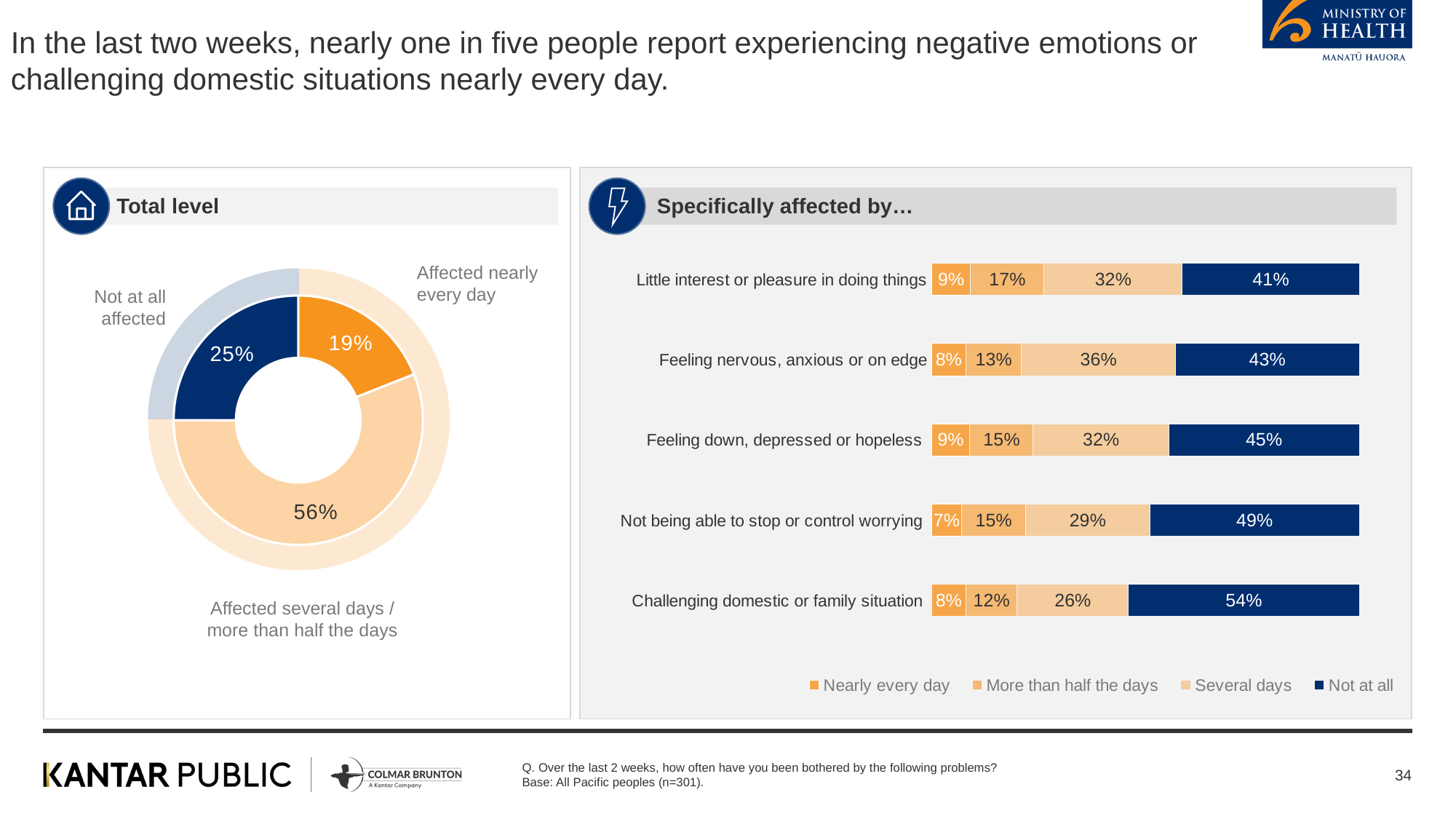
In the 'Total level' chart, what share of people were not at all affected? 25% How many items are listed in the 'Specifically affected by…' chart? 5 In the 'Specifically affected by…' chart, which item has the lowest 'Nearly every day' percentage? Not being able to stop or control worrying In the 'Specifically affected by…' chart, what percentage were not at all affected by a challenging domestic or family situation? 54% In the 'Specifically affected by…' chart, which item has the highest 'Not at all' percentage? Challenging domestic or family situation In the 'Specifically affected by…' chart, what is the difference between the 'Not at all' percentages for 'Not being able to stop or control worrying' and 'Little interest or pleasure in doing things'? 8% In the 'Total level' chart, what share of people were affected nearly every day? 19% In the 'Specifically affected by…' chart, is the 'More than half the days' value larger for 'Little interest or pleasure in doing things' or for 'Challenging domestic or family situation'? Little interest or pleasure in doing things In the 'Total level' chart, which segment is the largest? Affected several days / more than half the days What kind of chart is the 'Total level' chart? Donut (pie) chart How many series does the legend of the 'Specifically affected by…' chart list? 4 In the 'Specifically affected by…' chart, what percentage reported feeling nervous, anxious or on edge on several days? 36%